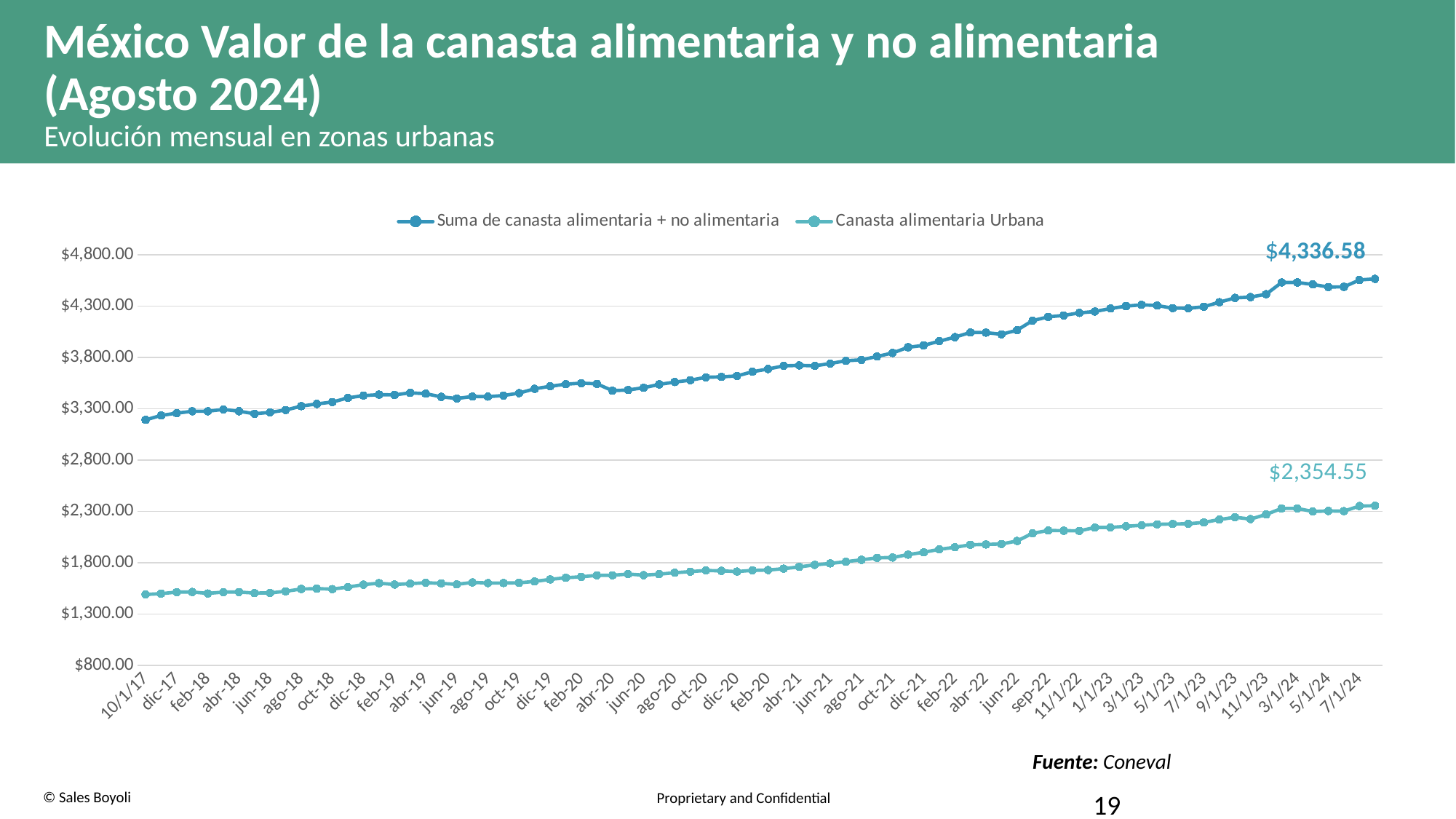
What kind of chart is shown on the slide? line chart What is the difference between the two labelled values, $4,336.58 and $2,354.55? $1,982.03 Which series has higher values throughout the chart, 'Suma de canasta alimentaria + no alimentaria' or 'Canasta alimentaria Urbana'? Suma de canasta alimentaria + no alimentaria Is the value of 'Canasta alimentaria Urbana' at 10/1/17 greater or less than $1,300.00? greater What is the latest labelled value for the series 'Suma de canasta alimentaria + no alimentaria'? $4,336.58 How many series does the legend list? 2 Is the value of 'Suma de canasta alimentaria + no alimentaria' at 10/1/17 greater or less than $3,300.00? less What is the subtitle shown under the main title of the slide? Evolución mensual en zonas urbanas Is the value of 'Suma de canasta alimentaria + no alimentaria' at 7/1/24 greater or less than $4,300.00? greater Do the values of 'Canasta alimentaria Urbana' generally rise or fall from 10/1/17 to 7/1/24? rise What source is cited for the chart data? Coneval What is the latest labelled value for the series 'Canasta alimentaria Urbana'? $2,354.55